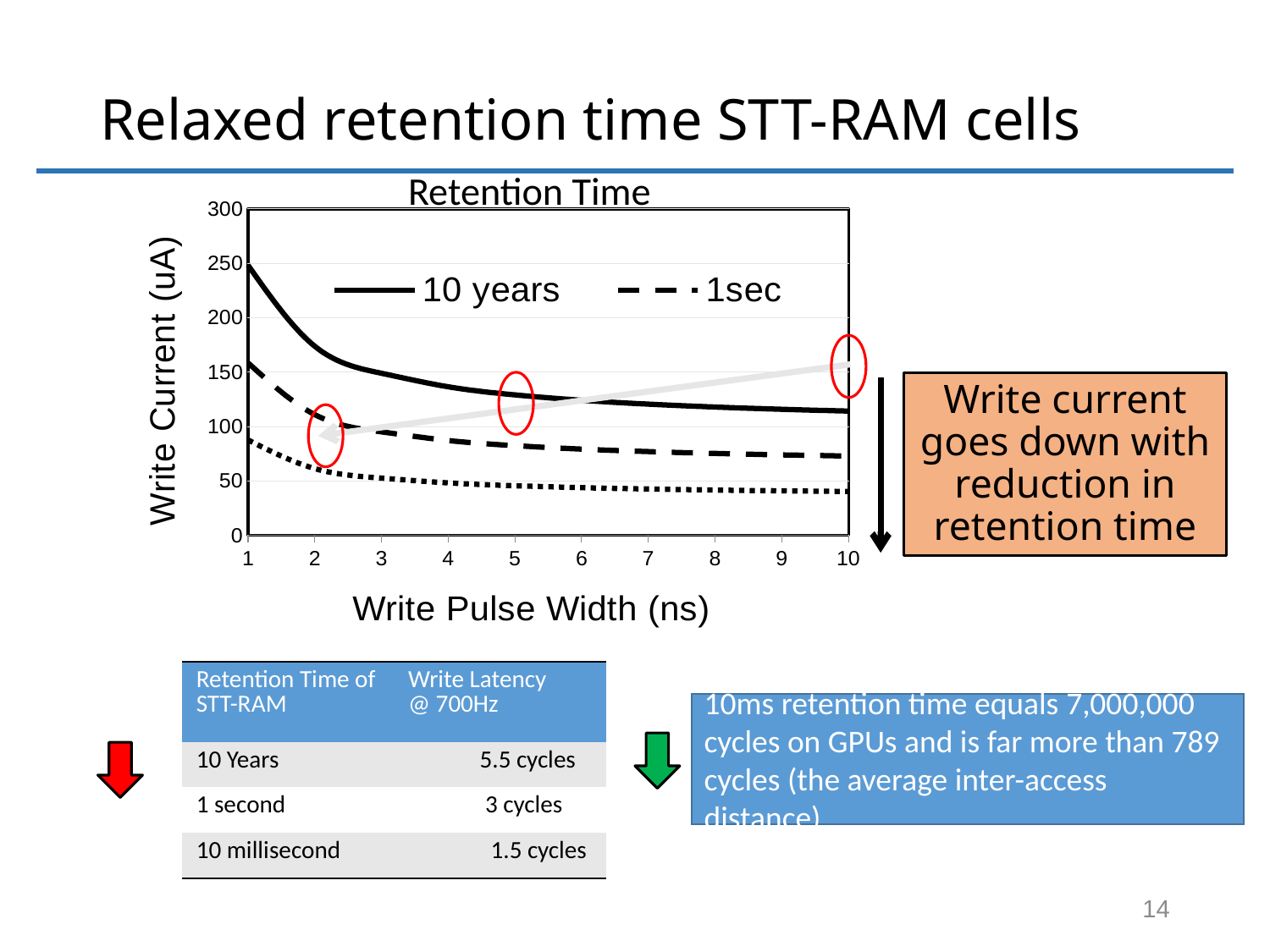
What kind of chart is shown on the slide? line chart Does the write current for the 1sec series rise or fall as write pulse width increases? fall At a write pulse width of 5 ns, which series has the higher write current, 10 years or 1sec? 10 years Does the write current for the 10 years series rise or fall as write pulse width increases? fall How many series does the chart legend list? 2 What is the title of the x axis of the chart? Write Pulse Width (ns) Is the write current for the 1sec series at a write pulse width of 10 ns greater or less than 100? less Is the write current for the 1sec series at a write pulse width of 1 ns greater or less than 200? less How many tick labels are shown on the x axis of the chart? 10 What is the title of the y axis of the chart? Write Current (uA) Is the write current for the 10 years series at a write pulse width of 1 ns greater or less than 200? greater